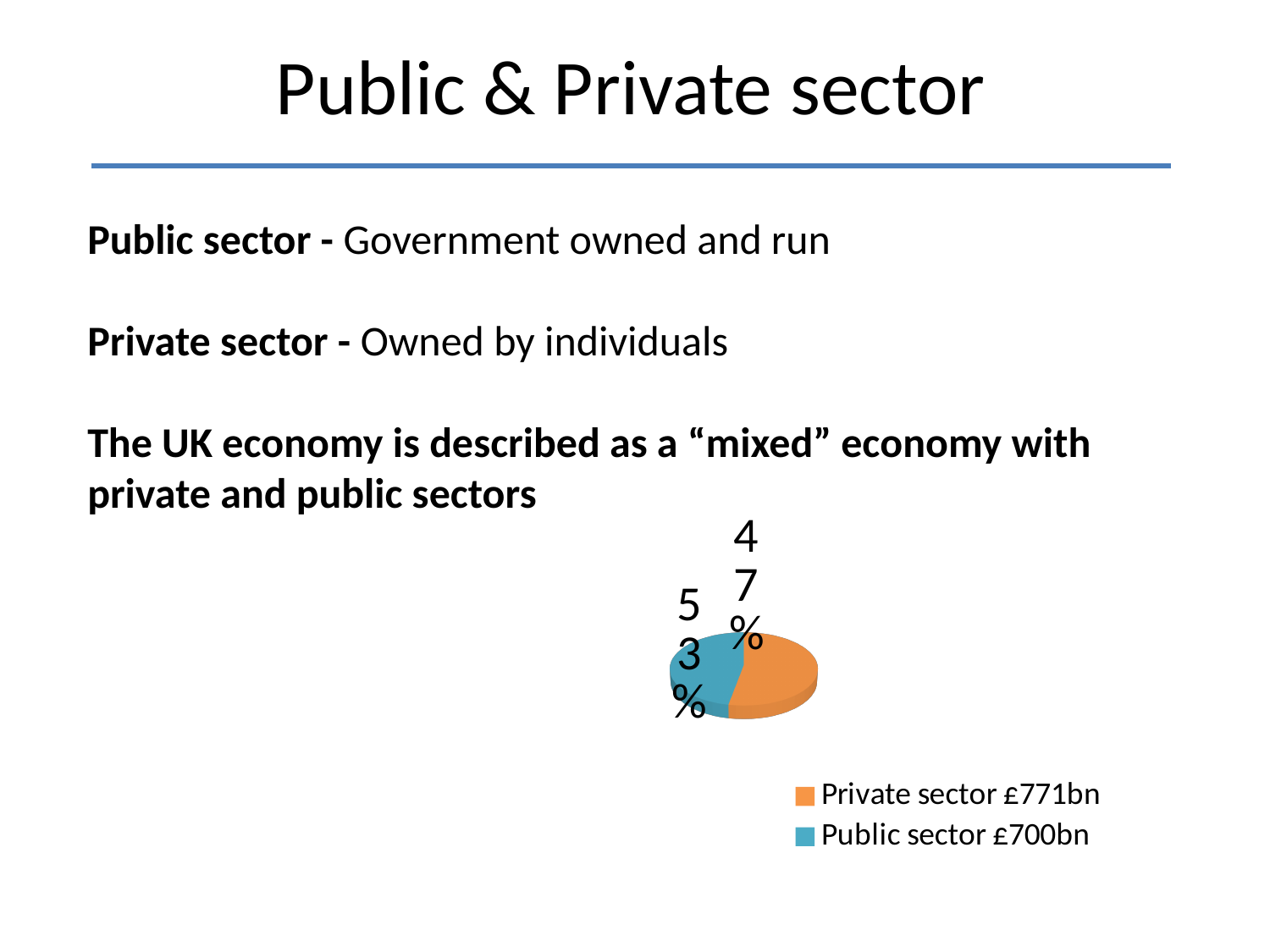
Which sector has the smaller value in the pie chart legend? Public sector What colour represents the Public sector in the pie chart? Blue Is the Private sector value larger or smaller than the Public sector value? Larger Which sector has the larger value in the pie chart legend? Private sector According to the legend, what is the value for the Public sector? £700bn How many entries does the legend of the pie chart list? 2 What two percentage labels are printed on the pie chart? 47% and 53% What colour represents the Private sector in the pie chart? Orange What is the difference between the Private sector value and the Public sector value shown in the legend? £71bn How many slices does the pie chart have? 2 According to the legend, what is the value for the Private sector? £771bn What kind of chart is shown on the slide? Pie chart